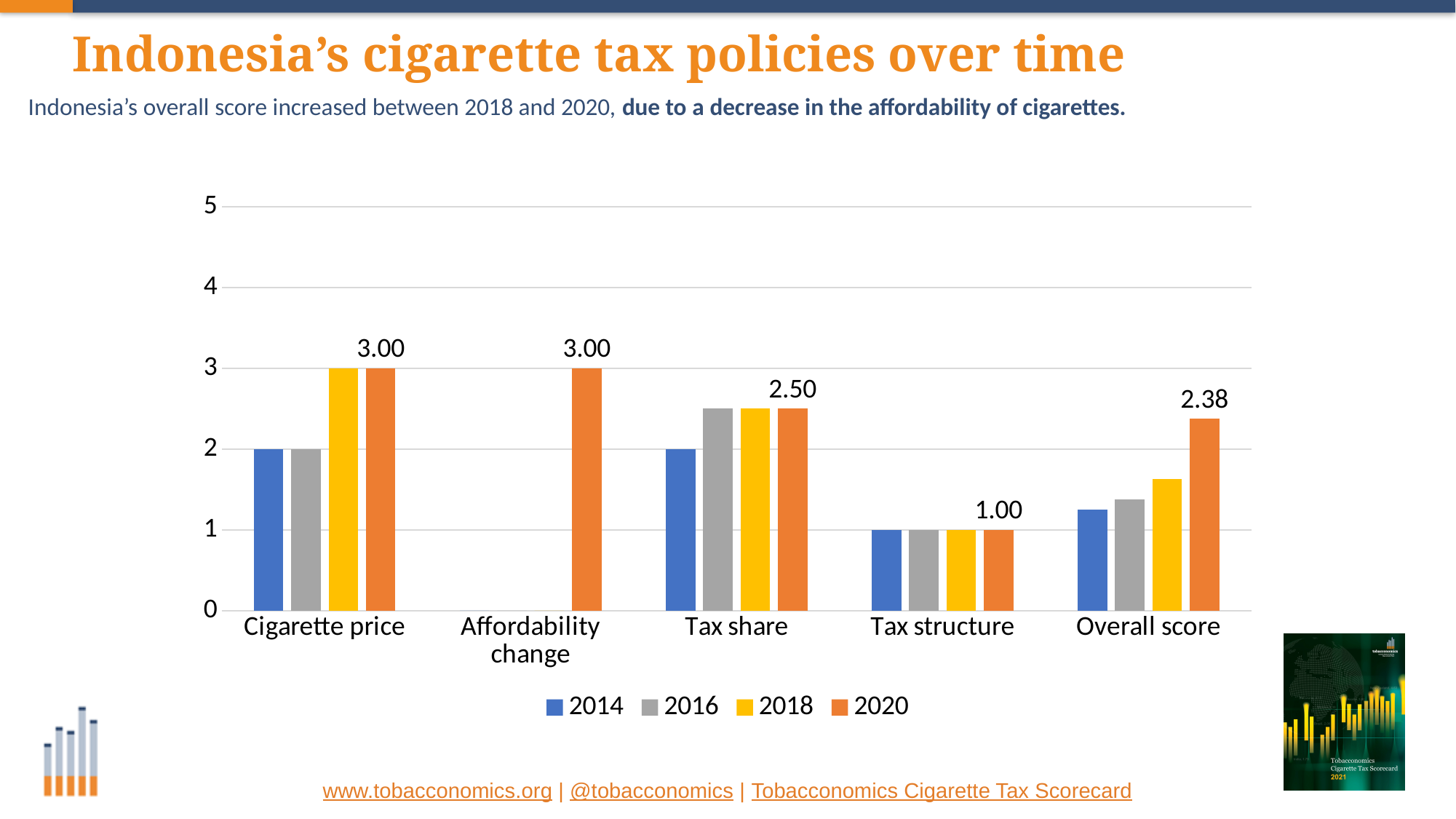
What is the difference between the 2020 values for Cigarette price and Overall score? 0.62 What is the 2020 value for Cigarette price? 3.00 How many categories are shown on the x axis? 5 Do the Overall score values rise or fall from 2014 to 2020? rise Which is larger in 2020: Tax share or Overall score? Tax share What is the 2020 value for Tax share? 2.50 What is the 2020 value for Tax structure? 1.00 Which category has the lowest 2020 value? Tax structure What is the 2020 value for Overall score? 2.38 Is the 2018 value for Overall score greater or less than 2? less How many series does the legend list? 4 What kind of chart is shown on the slide? bar chart